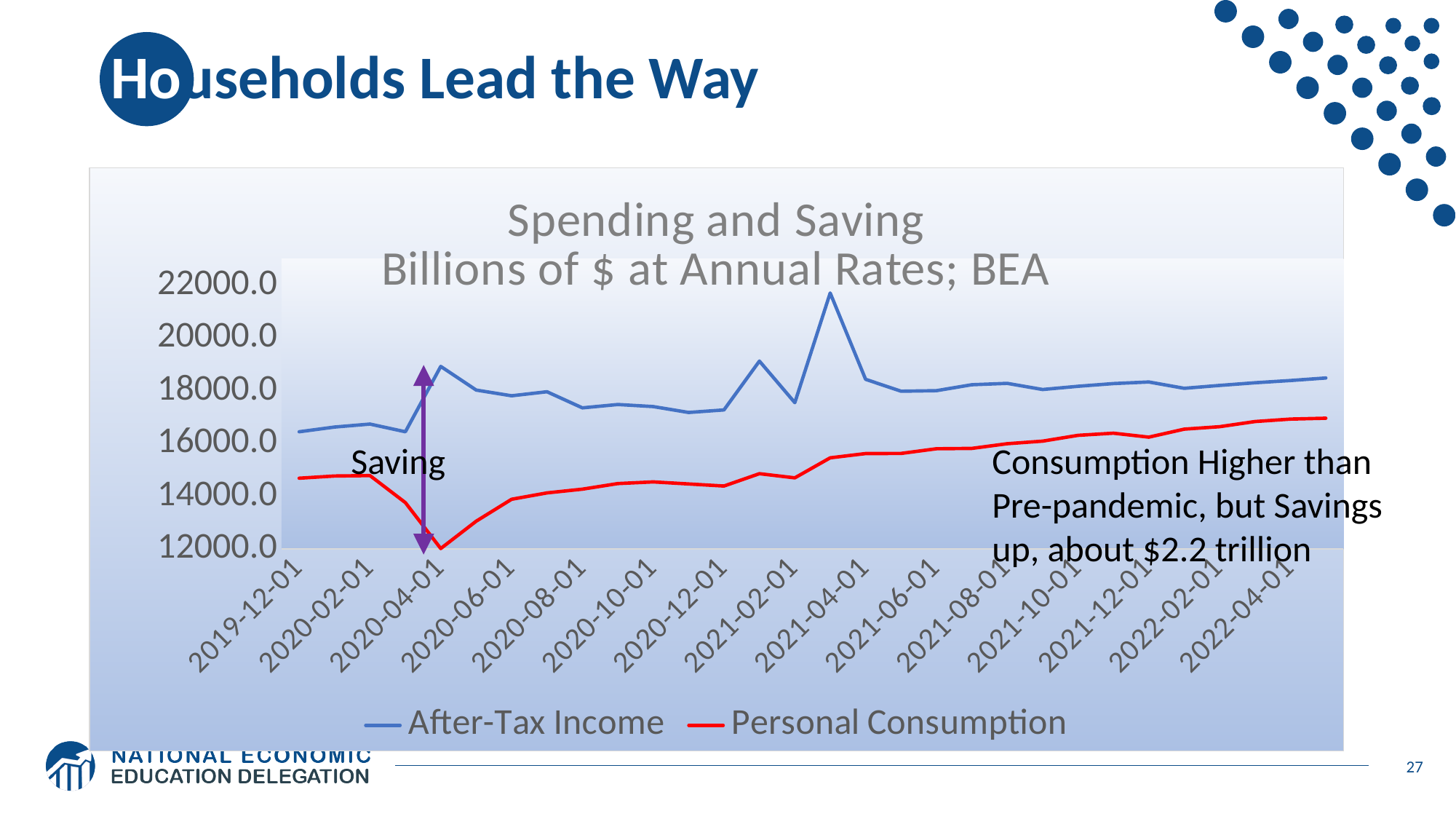
What are the two series named in the legend? After-Tax Income and Personal Consumption Is the peak value of After-Tax Income greater or less than 20000.0? greater What is the title of the chart? Spending and Saving Billions of $ at Annual Rates; BEA Which series reaches the highest value on the chart? After-Tax Income At which x-axis date does Personal Consumption reach its lowest value? 2020-04-01 Is the value of Personal Consumption at 2020-04-01 greater or less than 14000.0? less At 2020-04-01, which is larger: After-Tax Income or Personal Consumption? After-Tax Income What kind of chart is shown on the slide? Line chart How many series does the legend list? 2 Is the value of Personal Consumption at 2022-04-01 greater or less than 16000.0? greater Does Personal Consumption generally rise or fall from 2020-06-01 to 2022-04-01? rise